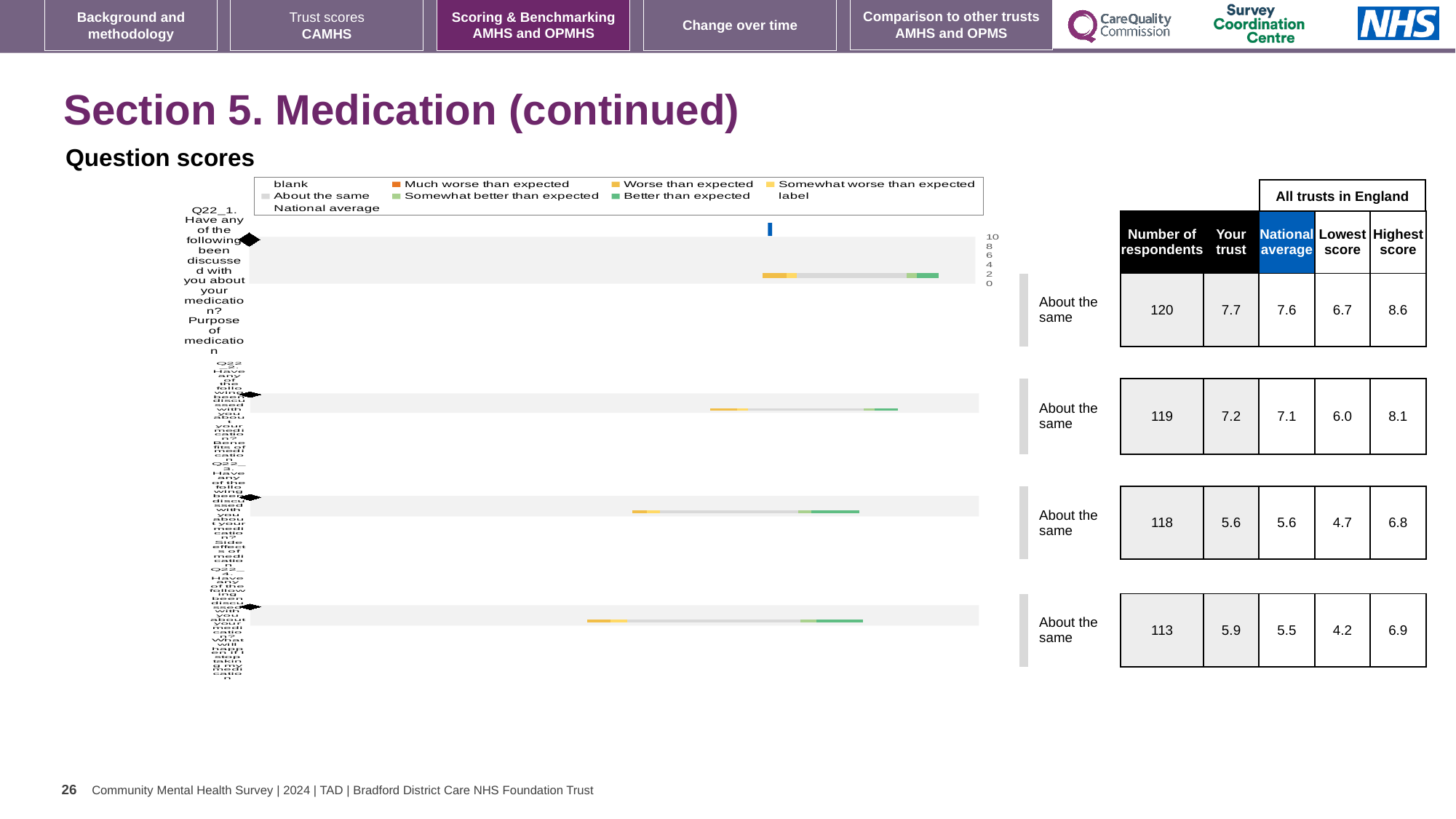
Which question row has the highest 'Your trust' score? Q22_1 (Purpose of medication), 7.7 For the second question row (Q22_2), which is larger: the 'Your trust' score or the national average? Your trust (7.2) Which question row has the lowest 'Your trust' score? Q22_3, 5.6 How many respondents are shown for Q22_1 (Purpose of medication)? 120 What is the lowest score across all trusts in England for the third question row (Q22_3)? 4.7 For the fourth question row (Q22_4), what is the difference between the 'Your trust' score and the national average? 0.4 How many question rows are plotted in the chart? 4 What kind of chart is used to show the question scores? Bar chart What is the 'Your trust' score for Q22_1 (Purpose of medication)? 7.7 What is the highest score across all trusts in England for the fourth question row (Q22_4)? 6.9 What benchmark category label is shown next to each of the four question rows? About the same What is the national average score for Q22_1 (Purpose of medication)? 7.6